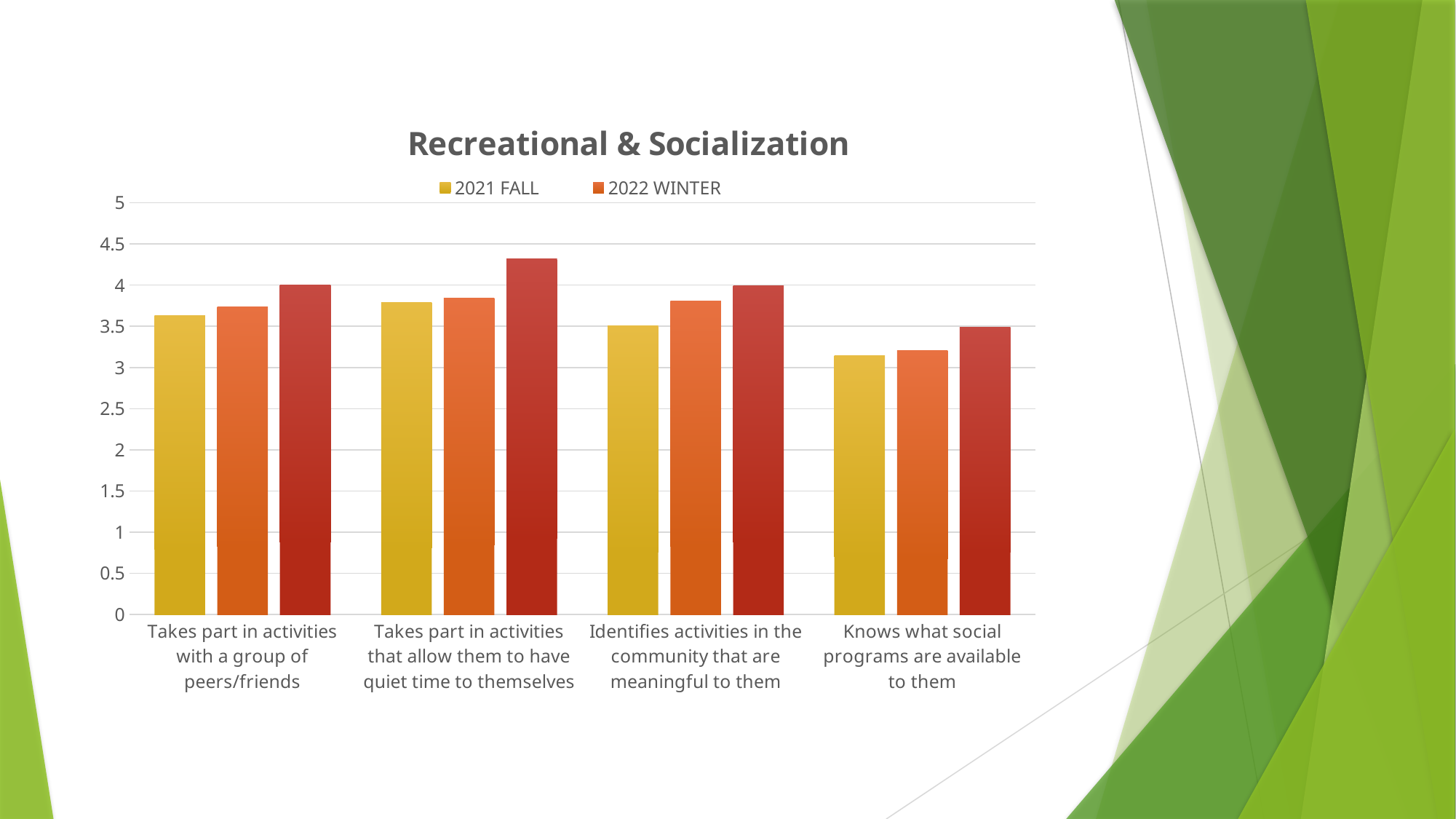
Which category has the lowest 2022 WINTER value? Knows what social programs are available to them Is the 2022 WINTER value for "Takes part in activities with a group of peers/friends" greater or less than 4? less Which category has the lowest 2021 FALL value? Knows what social programs are available to them How many series does the legend list? 2 What kind of chart is shown on the slide? bar chart What is the title of the chart? Recreational & Socialization For "Identifies activities in the community that are meaningful to them", which is larger: the 2021 FALL value or the 2022 WINTER value? 2022 WINTER How many categories are shown on the x axis? 4 Is the 2021 FALL value for "Knows what social programs are available to them" greater or less than 3.5? less Is the 2022 WINTER value for "Identifies activities in the community that are meaningful to them" greater or less than 3.5? greater Which series is shown in yellow in the legend? 2021 FALL